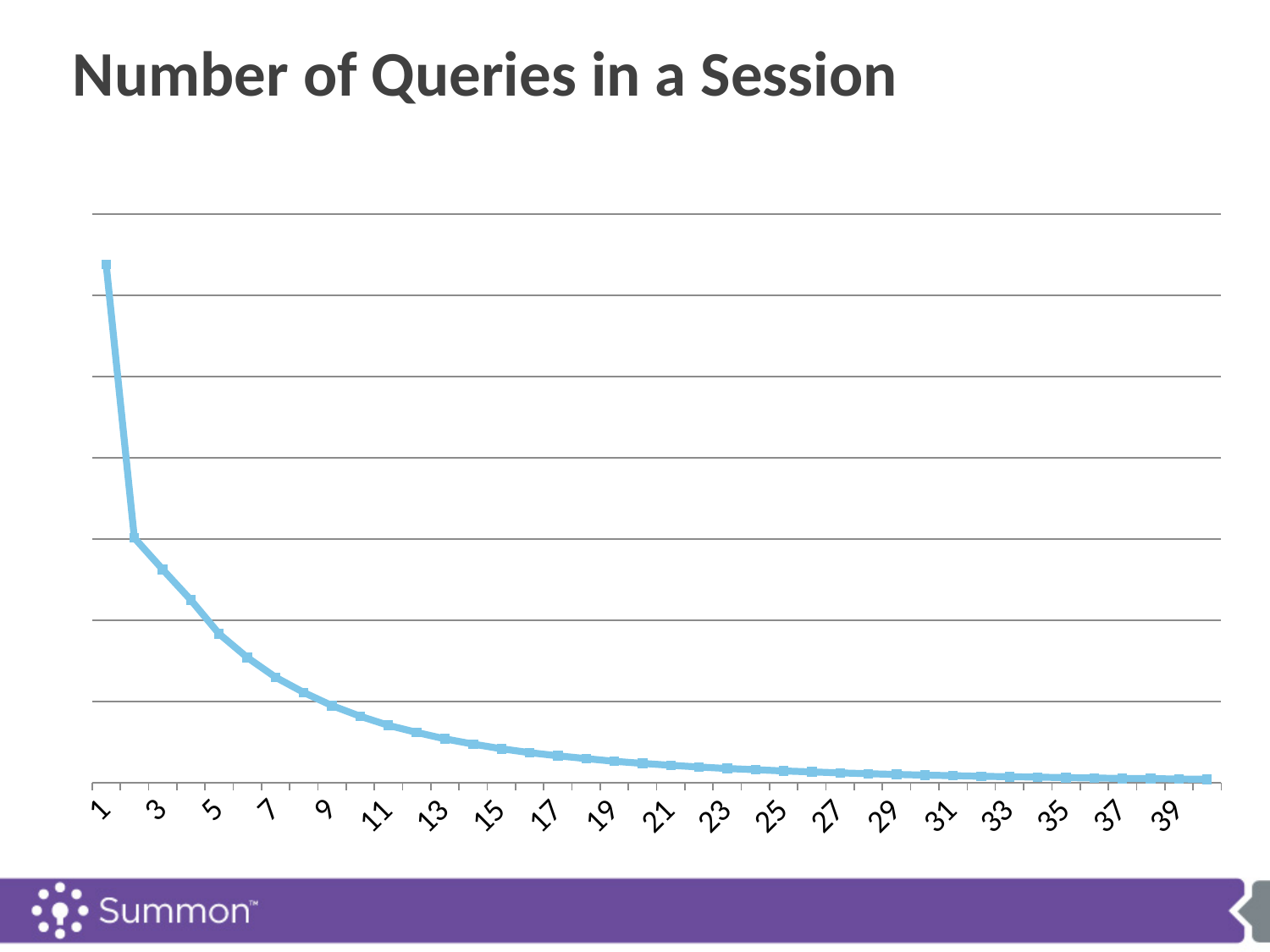
Which has the larger value, category 5 or category 9? 5 What kind of chart is shown on the slide? line chart What colour is the plotted line? light blue Is the drop in value between categories 1 and 3 larger or smaller than the drop between categories 3 and 5? larger Do the values rise or fall as you move from left to right along the x axis? fall Which has the larger value, category 1 or category 3? 1 Which category on the x axis has the highest value? 1 What is the title of the chart? Number of Queries in a Session